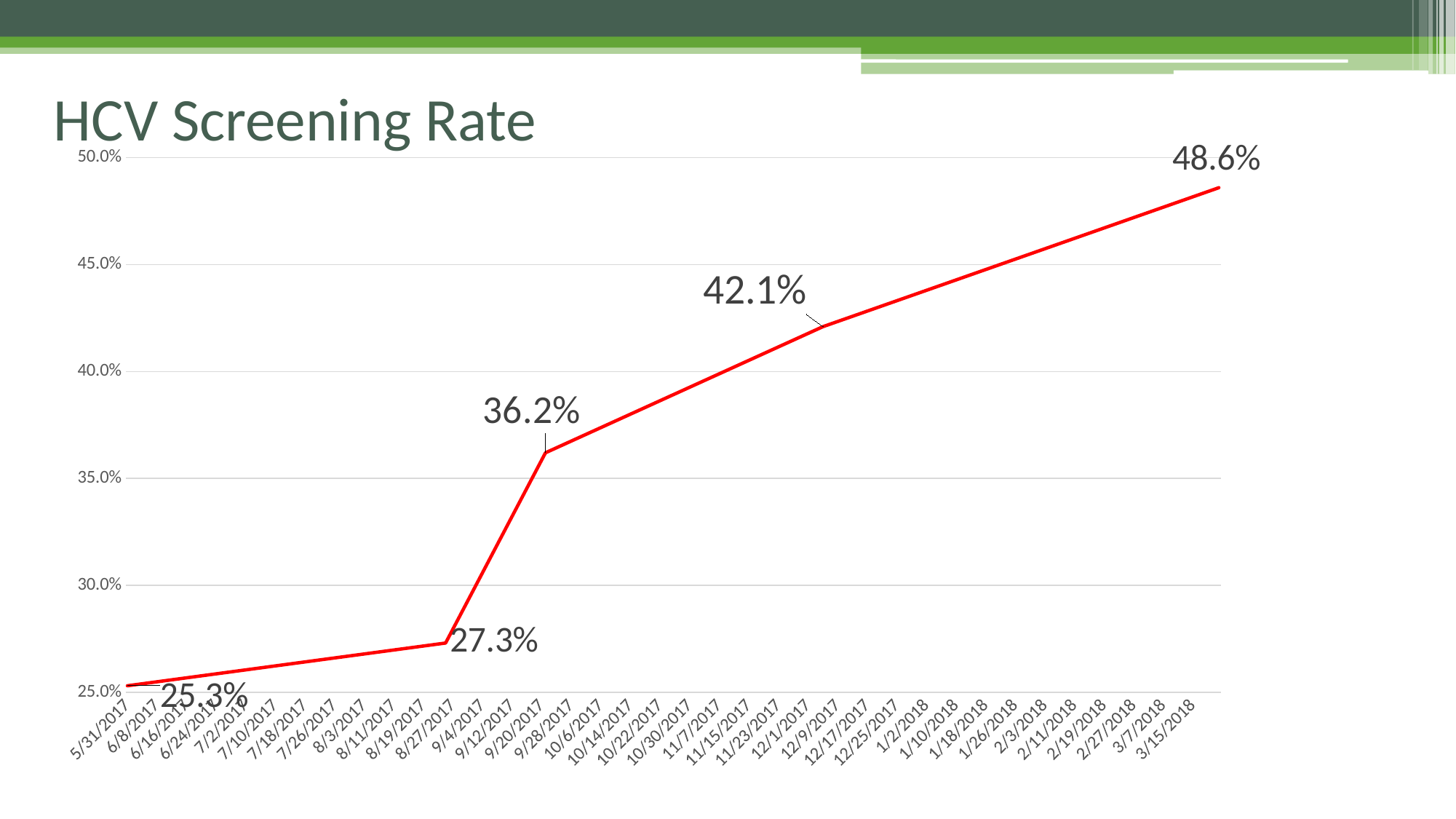
What is the lowest screening rate labeled on the chart? 25.3% What is the value of the first labeled data point on the line? 25.3% What is the title of the chart? HCV Screening Rate What is the value of the third labeled data point on the line? 36.2% What is the highest screening rate labeled on the chart? 48.6% What is the value of the last labeled data point on the line? 48.6% Does the screening rate rise or fall over time along the x axis? rises Which is larger, the fourth labeled point or the third labeled point? the fourth labeled point (42.1%) What kind of chart is shown on the slide? line chart What is the value of the second labeled data point on the line? 27.3% By how many percentage points did the screening rate increase from the first labeled point (25.3%) to the last labeled point (48.6%)? 23.3 percentage points What is the difference between the 36.2% point and the 27.3% point? 8.9 percentage points